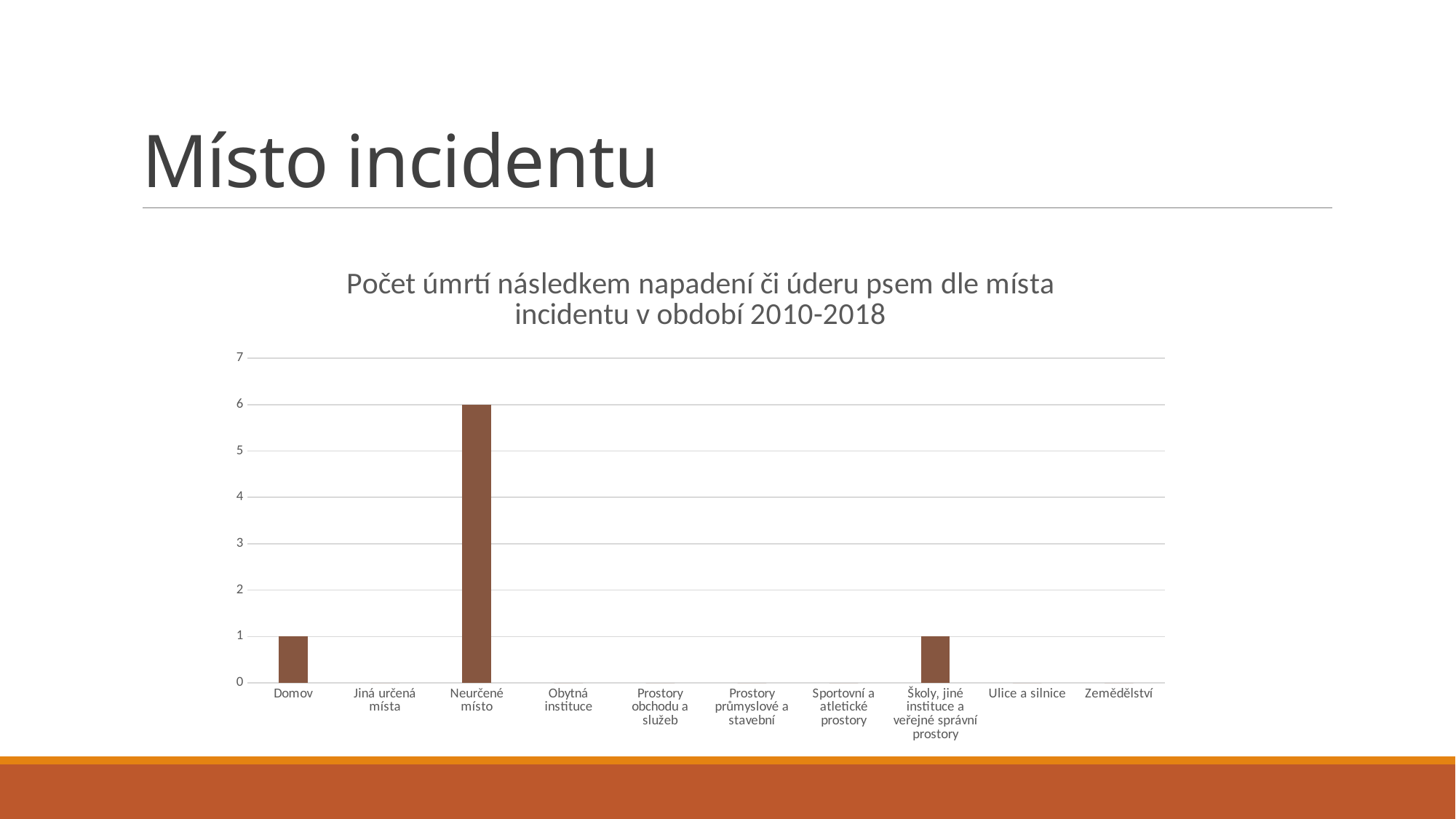
How many categories have a value greater than 0? 3 What is the title of the chart? Počet úmrtí následkem napadení či úderu psem dle místa incidentu v období 2010-2018 Is the value for Neurčené místo greater or less than 5? greater What is the value for Ulice a silnice? 0 What is the difference between the values for Neurčené místo and Domov? 5 What is the value for Školy, jiné instituce a veřejné správní prostory? 1 Which category has the highest value in the chart? Neurčené místo Which is larger, the value for Neurčené místo or the value for Domov? Neurčené místo What kind of chart is shown on the slide? bar chart What is the value for Neurčené místo? 6 How many categories are shown on the x axis of the chart? 10 What is the value for Domov? 1